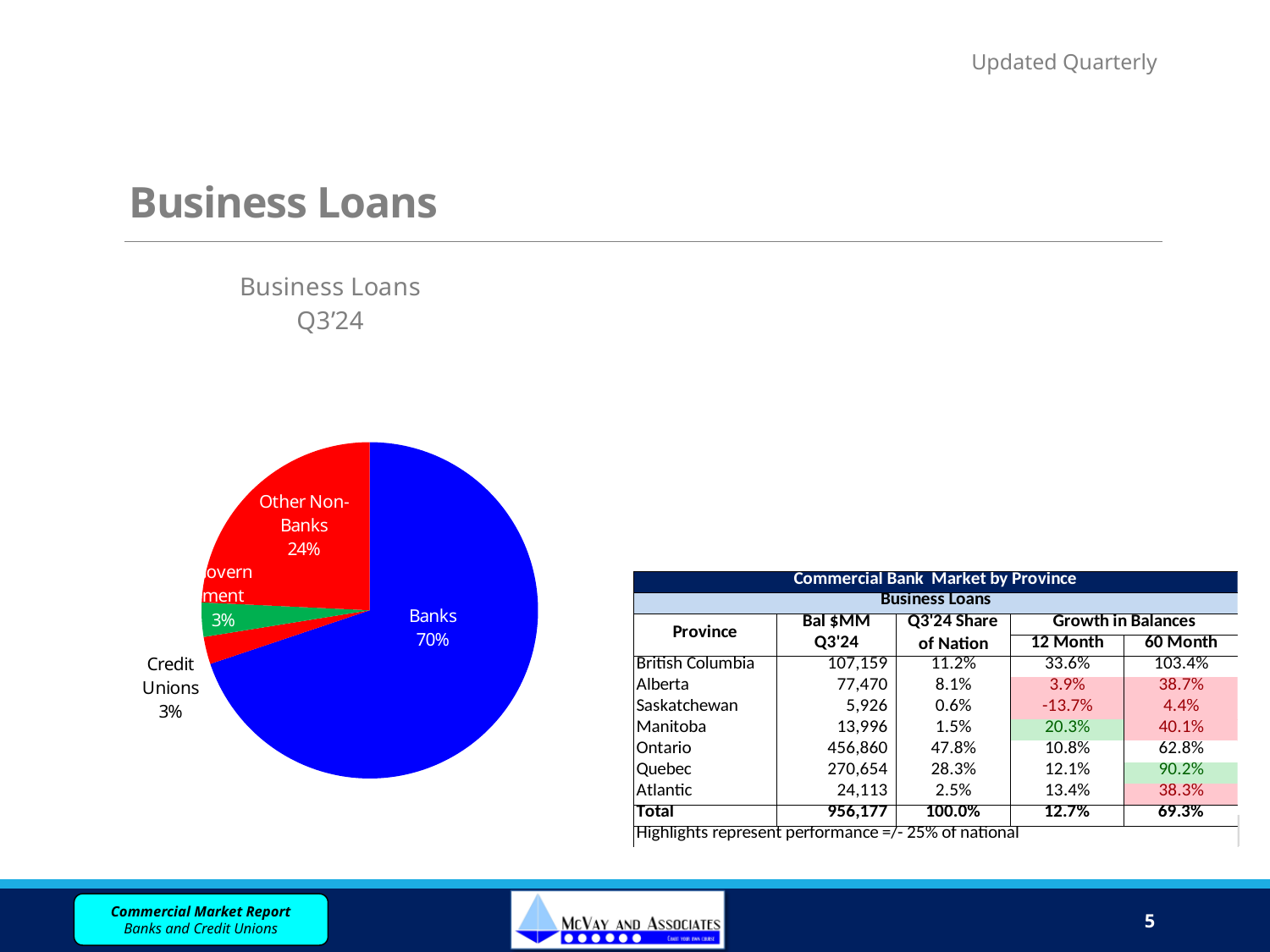
How many slices does the pie chart have? 4 Which is larger in the pie chart, Other Non-Banks or Credit Unions? Other Non-Banks What is the title of the pie chart? Business Loans Q3'24 What kind of chart is shown on the slide? Pie chart What share of the pie chart do Credit Unions hold? 3% What is the combined share of Banks and Other Non-Banks in the pie chart? 94% What colour is the Banks slice of the pie chart? Blue What share of the pie chart do Other Non-Banks hold? 24% Which category has the largest slice of the pie chart? Banks What is the difference in percentage points between the Banks slice and the Other Non-Banks slice? 46 What share of the pie chart do Banks hold? 70%